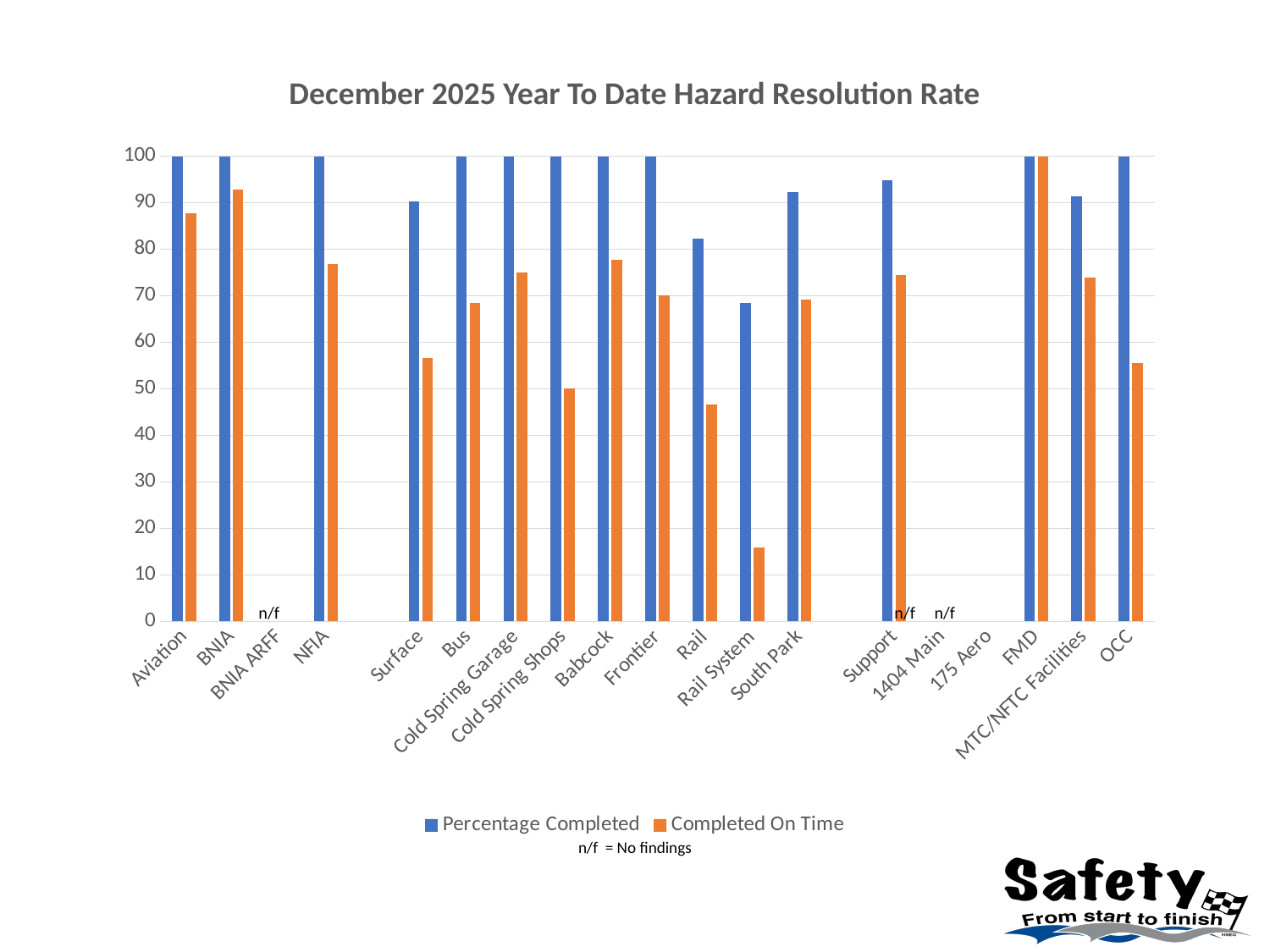
What is the Completed On Time value for FMD? 100 Which category has the lowest Completed On Time value? Rail System Which has the larger Percentage Completed value, Rail or Rail System? Rail What is the Percentage Completed value for Aviation? 100 Is the Completed On Time value for Surface greater or less than 50? greater What kind of chart is shown on the slide? Bar chart What is the title of the chart? December 2025 Year To Date Hazard Resolution Rate How many series does the legend list? 2 Is the Percentage Completed value for Rail greater or less than 90? less How many categories are marked n/f (no findings)? 3 Which has the larger Completed On Time value, BNIA or Bus? BNIA Is the Completed On Time value for Rail System greater or less than 20? less